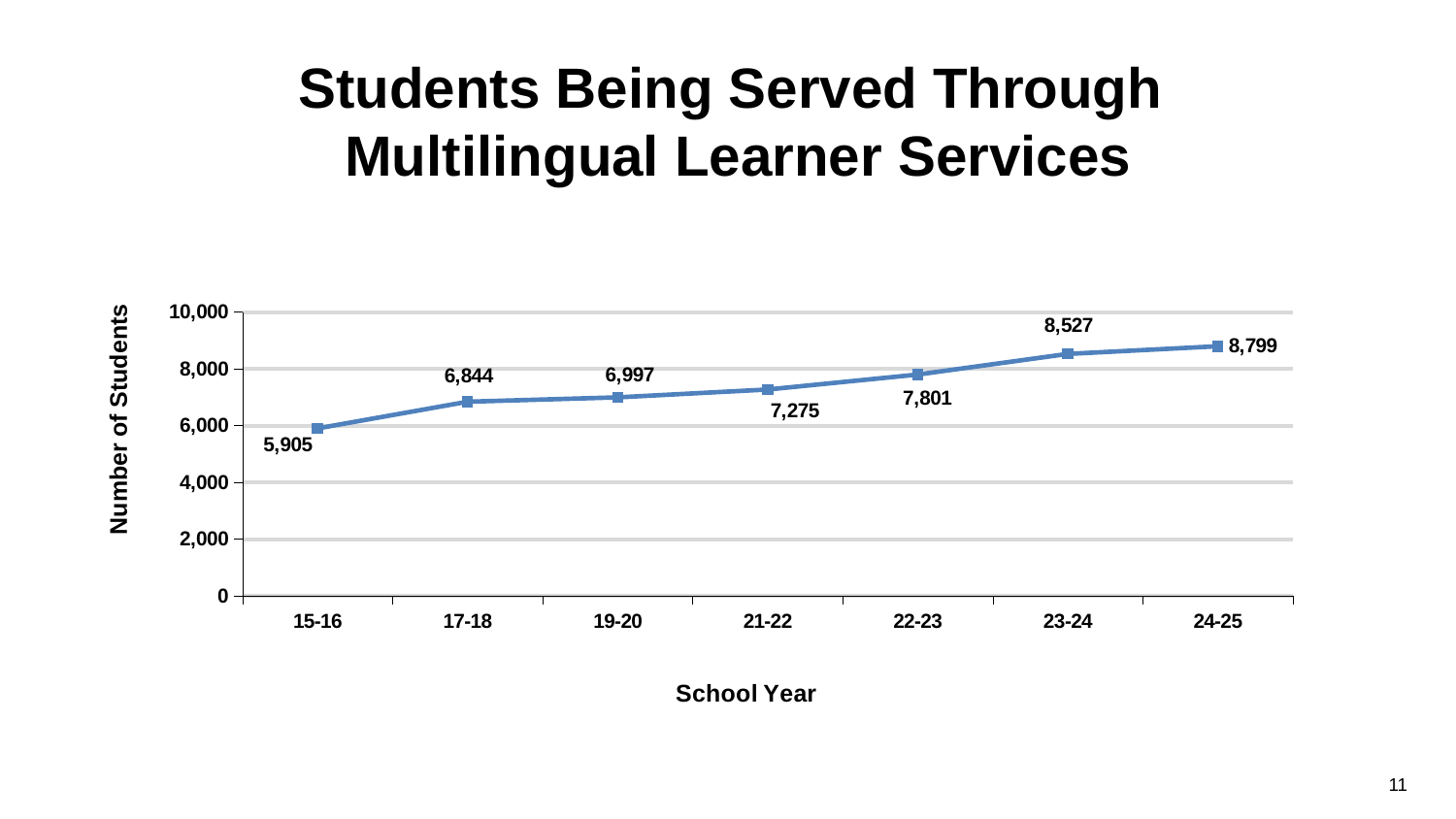
Which school year has more students, 19-20 or 21-22? 21-22 What is the number of students for the 22-23 school year? 7,801 What kind of chart is shown on the slide? line chart What is the difference in the number of students between 24-25 and 15-16? 2,894 Do the values rise or fall from 15-16 to 24-25? rise Is the value for 17-18 greater or less than 6,000? greater What is the number of students for the 24-25 school year? 8,799 What is the difference in the number of students between 23-24 and 22-23? 726 Which school year has the highest number of students? 24-25 How many school years are plotted on the chart? 7 Which school year has the lowest number of students? 15-16 What is the number of students for the 15-16 school year? 5,905